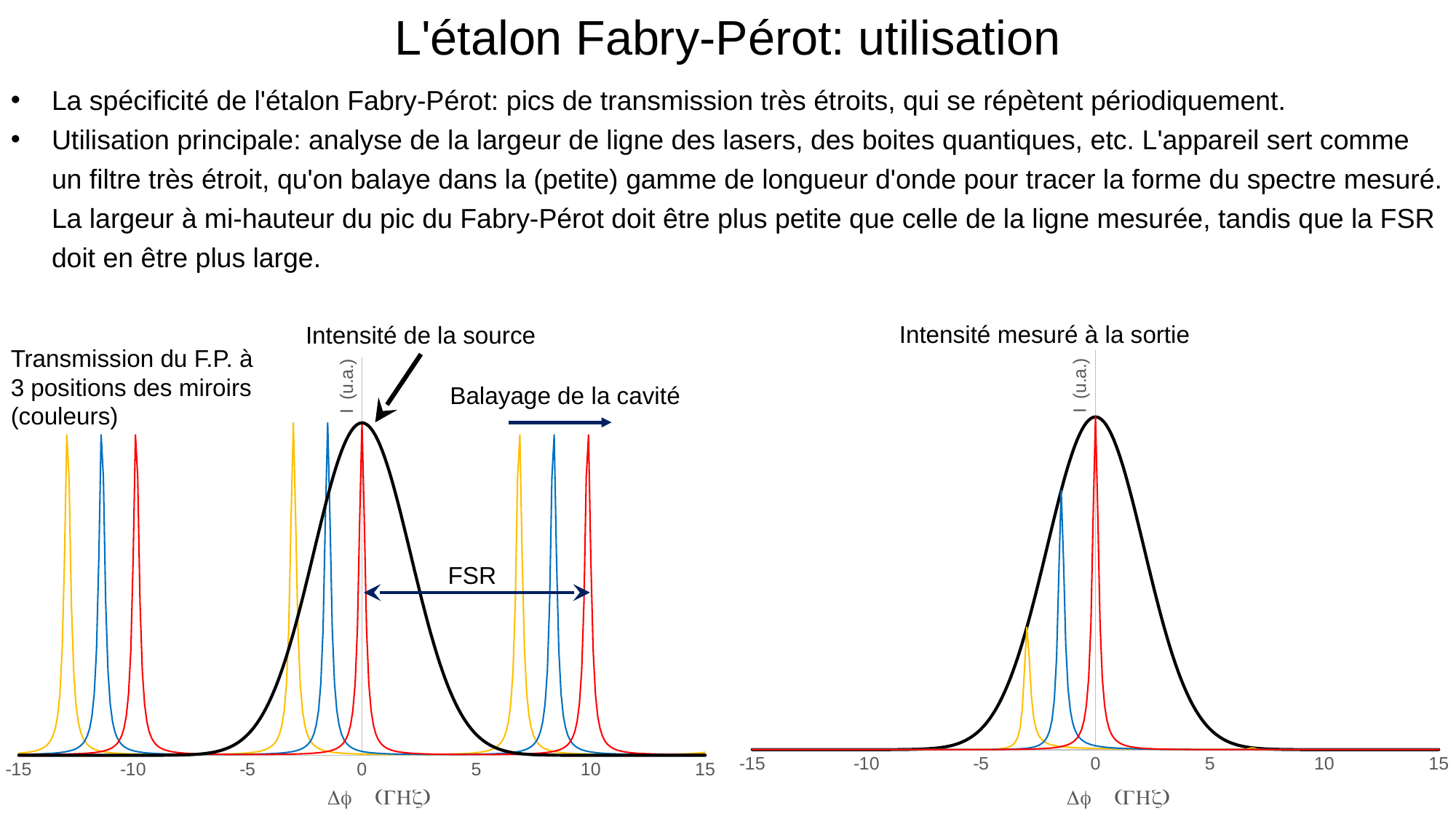
On the right chart (Intensité mesuré à la sortie), which coloured peak is the tallest? red What kind of chart is the left chart on the slide? line chart What is the lowest value shown on the x axis of the left chart? -15 On the right chart, is the blue peak taller or shorter than the yellow peak? taller On the right chart (Intensité mesuré à la sortie), which coloured peak is the lowest? yellow On the left chart, at what x value does the black curve reach its maximum? 0 What is the y-axis label of the left chart? I (u.a.) What is the highest value shown on the x axis of the right chart? 15 On the right chart, is the x position of the yellow peak greater or less than 0? less What is the title written above the right chart? Intensité mesuré à la sortie On the left chart, how many peaks does the red curve show? 3